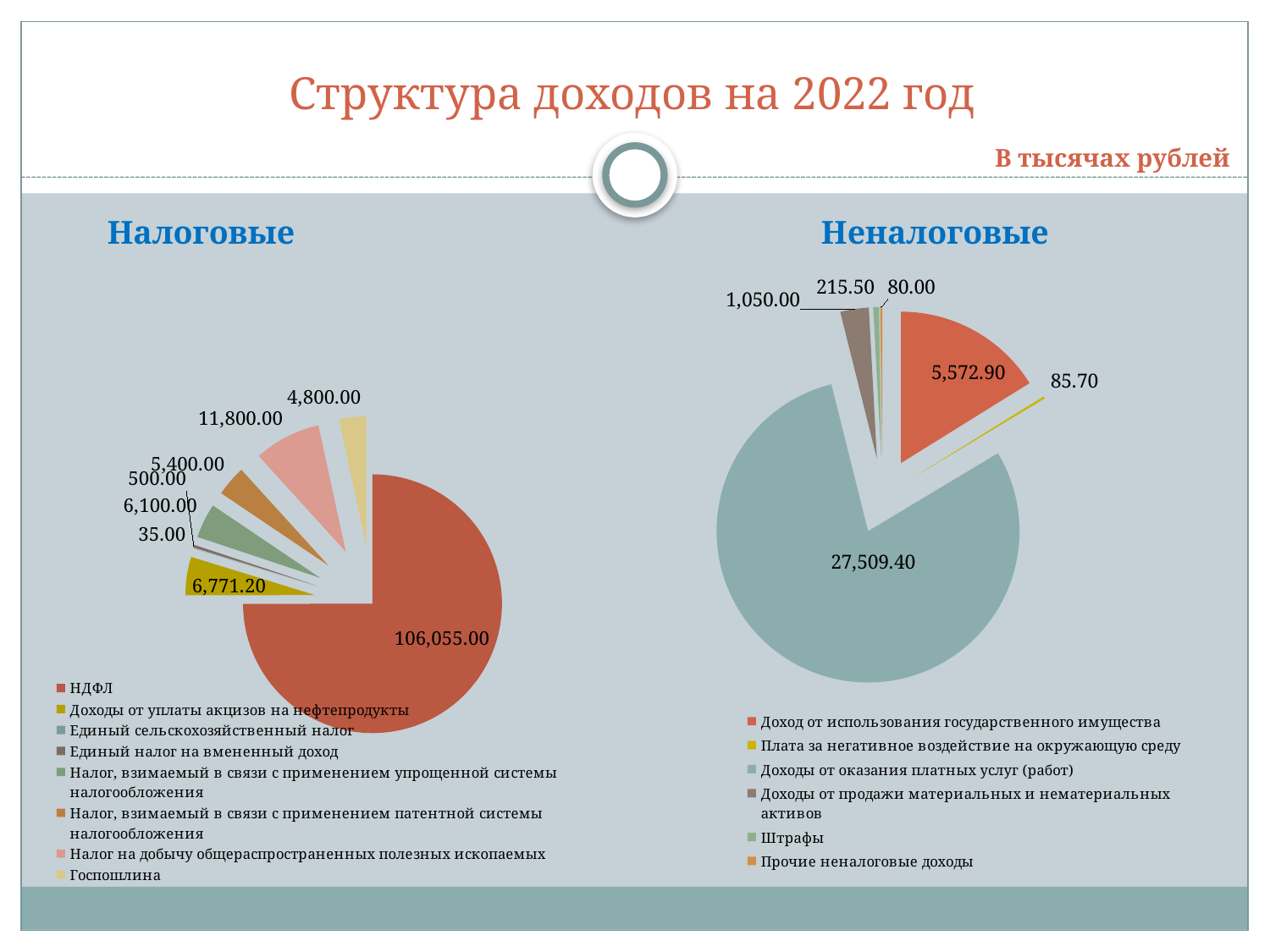
In the Неналоговые pie chart, what is the value for Доходы от оказания платных услуг (работ)? 27,509.40 What type of chart is used for Неналоговые? Pie chart In the Неналоговые pie chart, which category has the largest value? Доходы от оказания платных услуг (работ) In the Налоговые pie chart, which category has the smallest value? Единый сельскохозяйственный налог In the Неналоговые pie chart, what is the value for Штрафы? 215.50 How many categories does the legend of the Неналоговые pie chart list? 6 In the Налоговые pie chart, what is the value for Госпошлина? 4,800.00 In the Налоговые pie chart, what is the value for Единый сельскохозяйственный налог? 35.00 How many categories does the legend of the Налоговые pie chart list? 8 In the Неналоговые pie chart, which is larger: Доход от использования государственного имущества or Доходы от продажи материальных и нематериальных активов? Доход от использования государственного имущества In the Налоговые pie chart, what is the value for НДФЛ? 106,055.00 In the Налоговые pie chart, what is the difference between Налог на добычу общераспространенных полезных ископаемых and Госпошлина? 7,000.00